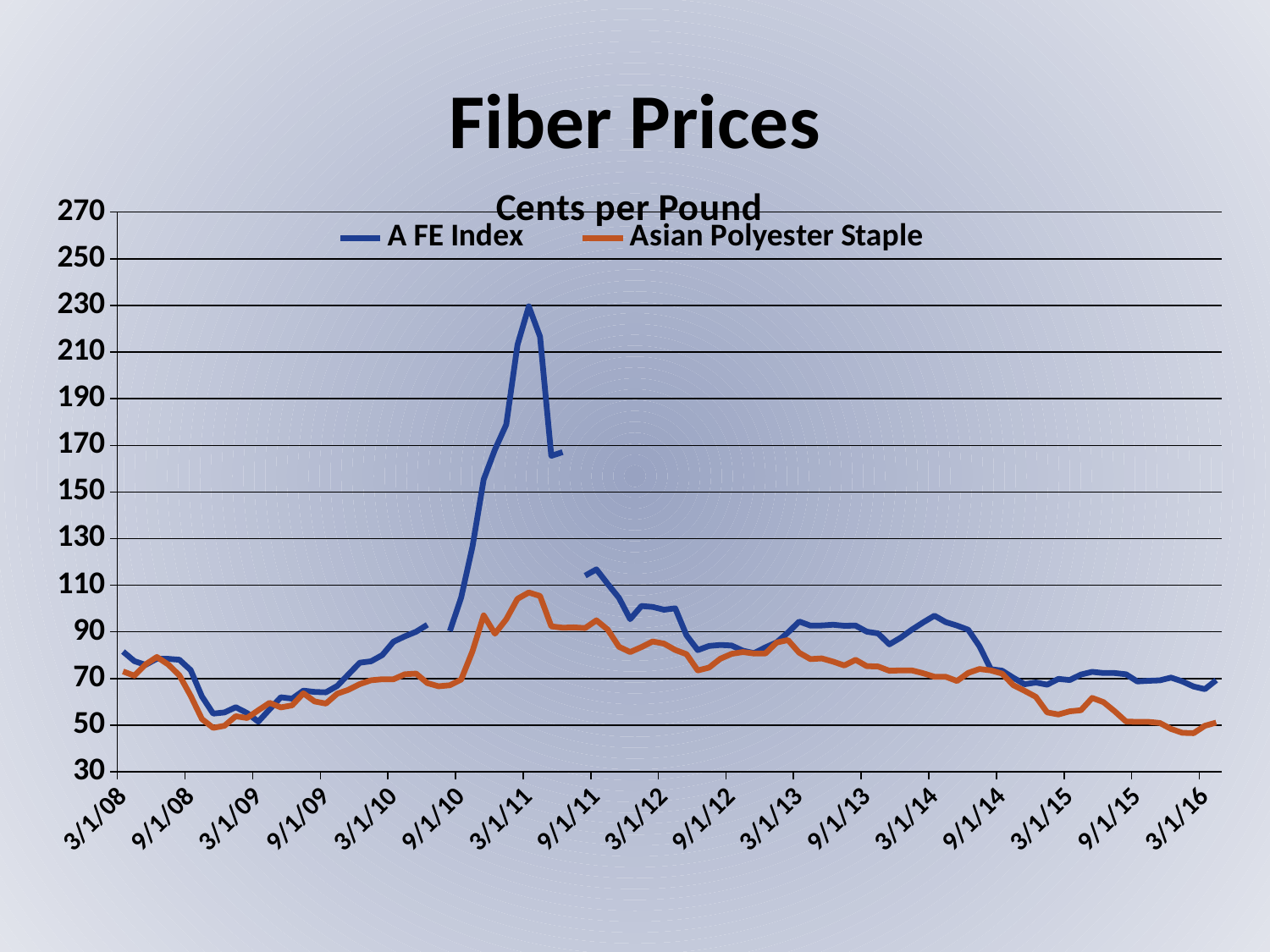
Is the value of Asian Polyester Staple at 3/1/11 greater or less than 90? greater Does the A FE Index rise or fall between 3/1/14 and 3/1/15? Fall At 3/1/16, which series has the higher value, A FE Index or Asian Polyester Staple? A FE Index What unit is given in the chart subtitle? Cents per Pound What is the title of the chart? Cents per Pound Which series reaches the highest value on the chart? A FE Index Is the peak value of the A FE Index greater or less than 210? greater What kind of chart is shown on the slide? Line chart How many series does the legend list? 2 Around which x-axis date does the A FE Index reach its peak? 3/1/11 Is the value of the A FE Index at 3/1/09 greater or less than 70? less